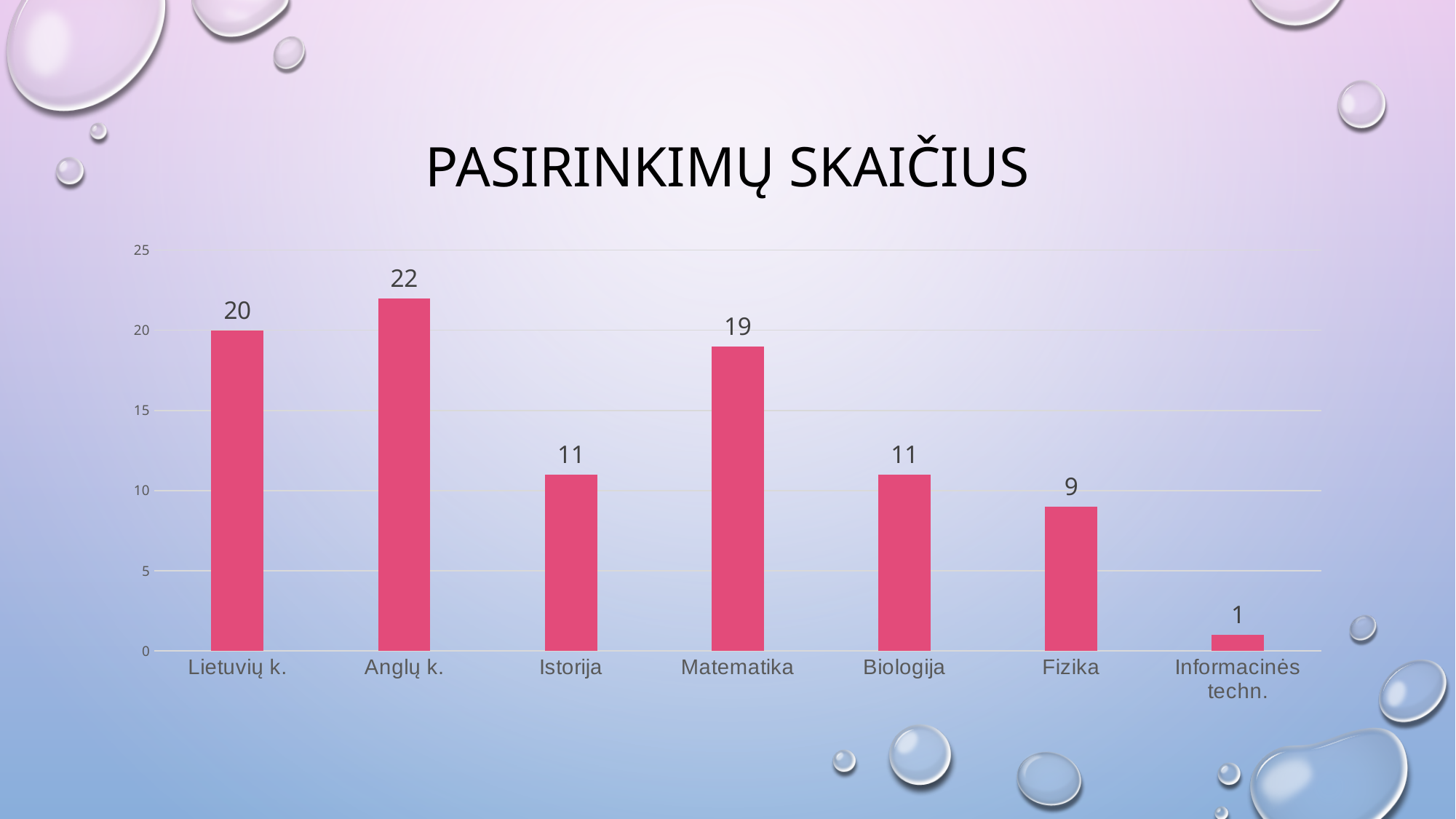
What is the value for Matematika? 19 Which category has the highest value? Anglų k. What kind of chart is shown on the slide? bar chart Which is larger, the value for Lietuvių k. or the value for Istorija? Lietuvių k. Is the value for Biologija greater or less than 15? less What is the value for Fizika? 9 What is the difference between the values for Matematika and Fizika? 10 What is the difference between the values for Anglų k. and Lietuvių k.? 2 What is the title of the slide? PASIRINKIMŲ SKAIČIUS What is the value for Anglų k.? 22 Which category has the lowest value? Informacinės techn. How many categories are shown on the x axis? 7